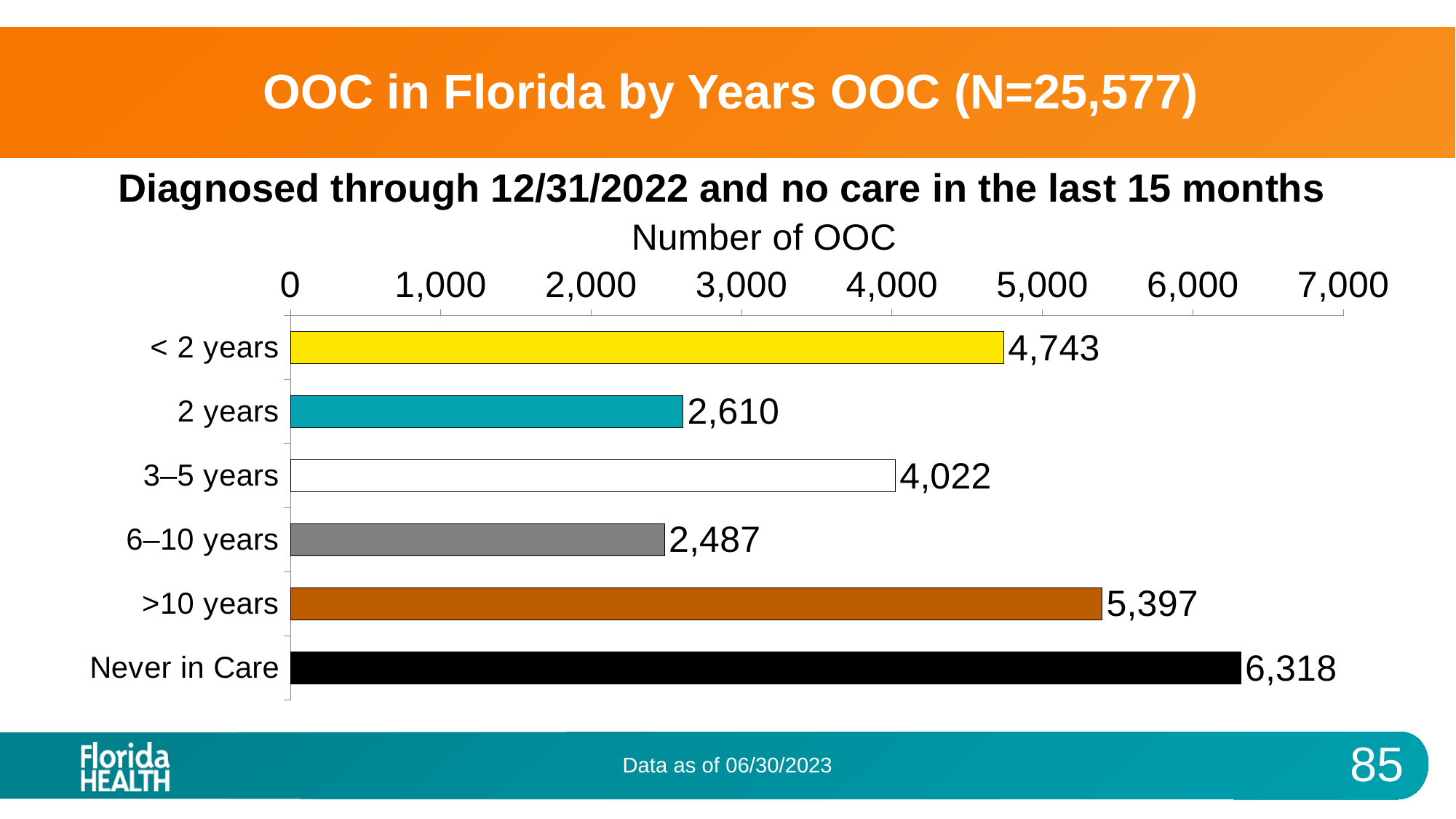
What is the number of OOC for the '6–10 years' category? 2,487 Is the value for '>10 years' greater or less than 5,000? greater What is the difference between the number of OOC for '>10 years' and '2 years'? 2,787 Which category has the lowest number of OOC? 6–10 years What is the number of OOC for the '< 2 years' category? 4,743 Which category has the highest number of OOC? Never in Care How many categories are shown in the chart? 6 What is the number of OOC for 'Never in Care'? 6,318 What is the title of the chart's horizontal axis? Number of OOC What kind of chart is shown on the slide? Bar chart Which is larger, the number of OOC for '< 2 years' or for '3–5 years'? < 2 years What colour is the bar for '2 years'? Teal